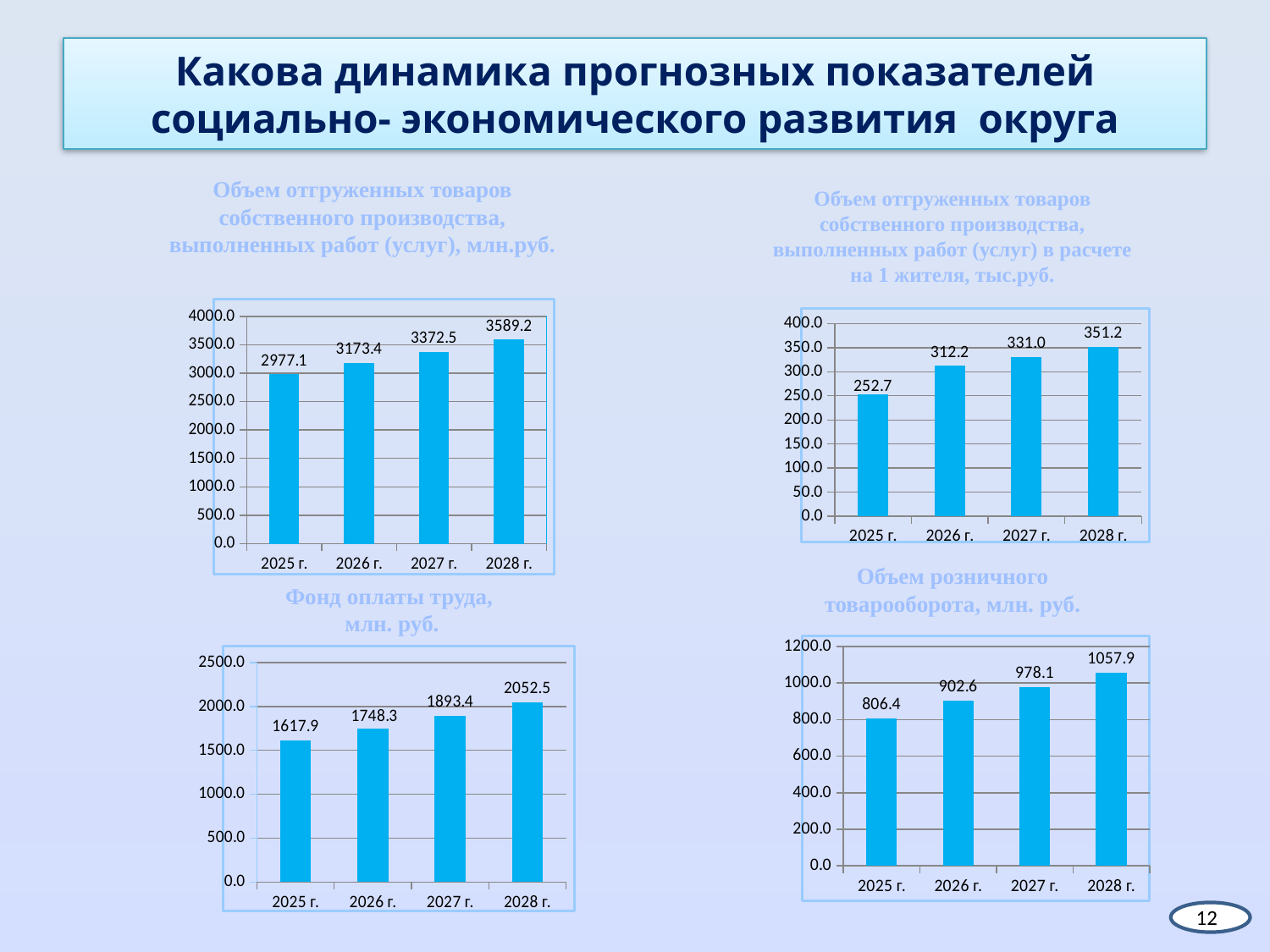
In the bottom-left chart (Фонд оплаты труда, млн. руб.), what is the value for 2027 г.? 1893.4 In the bottom-left chart (Фонд оплаты труда, млн. руб.), is the value for 2028 г. greater or less than 2000.0? greater In the top-left chart (Объем отгруженных товаров, млн.руб.), what is the difference between the values for 2028 г. and 2025 г.? 612.1 In the top-left chart (Объем отгруженных товаров собственного производства, выполненных работ (услуг), млн.руб.), what is the value for 2026 г.? 3173.4 In the top-right chart (в расчете на 1 жителя, тыс.руб.), which year has the lowest value? 2025 г. In the bottom-right chart (Объем розничного товарооборота, млн. руб.), which is larger, the value for 2026 г. or 2027 г.? 2027 г. In the top-right chart (Объем отгруженных товаров в расчете на 1 жителя, тыс.руб.), what is the value for 2025 г.? 252.7 In the top-right chart (в расчете на 1 жителя, тыс.руб.), do the values rise or fall from 2025 г. to 2028 г.? rise In the bottom-right chart (Объем розничного товарооборота, млн. руб.), what is the value for 2028 г.? 1057.9 In the bottom-left chart (Фонд оплаты труда, млн. руб.), how many years are shown on the x axis? 4 In the top-left chart (Объем отгруженных товаров, млн.руб.), which year has the highest value? 2028 г. What type of chart is the bottom-right chart (Объем розничного товарооборота, млн. руб.)? bar chart